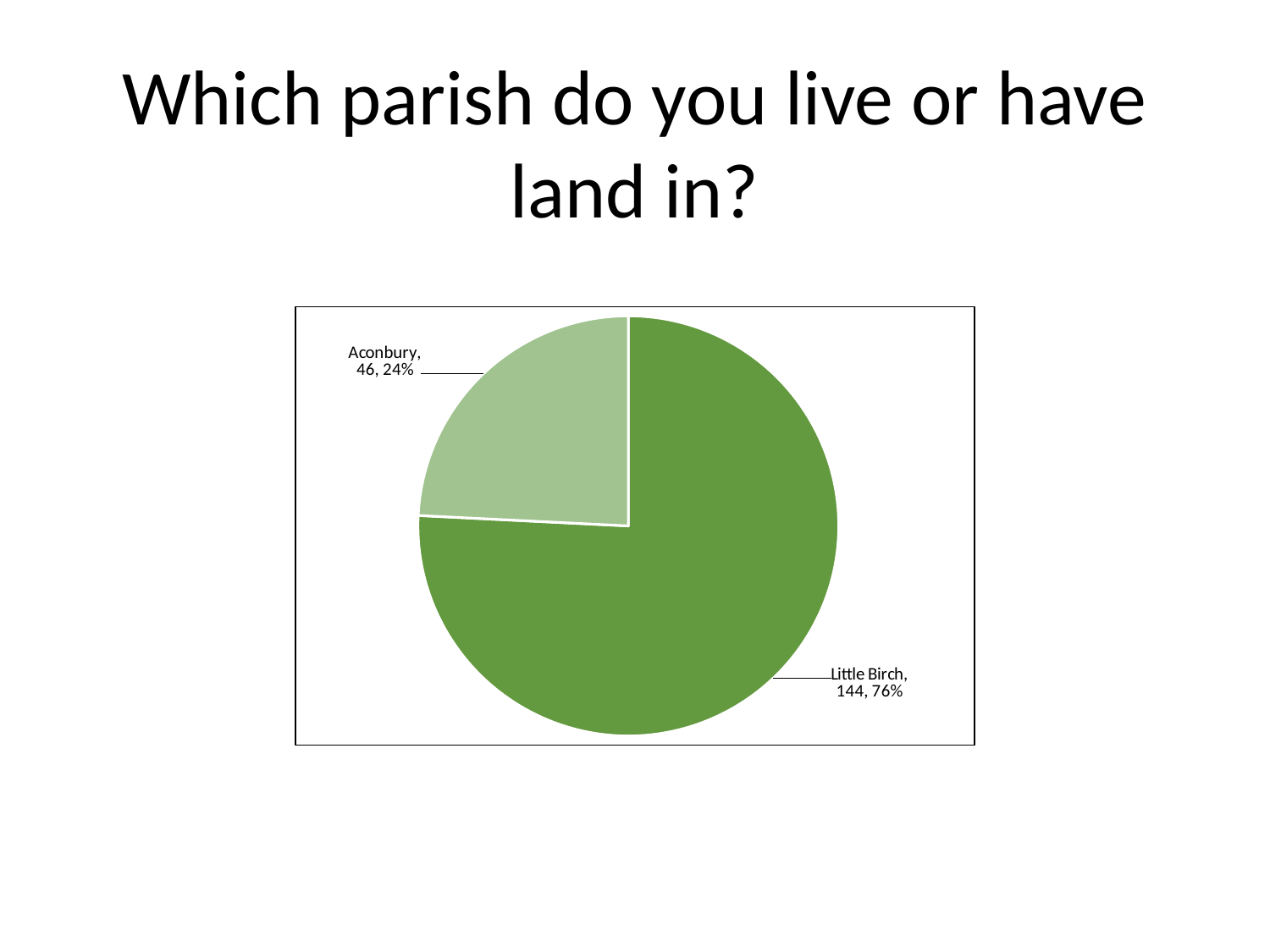
What is the value for Aconbury? 46 What share of the pie does Aconbury represent? 24% Which parish has the smallest slice? Aconbury What is the total of the two slices in the pie chart? 190 What is the difference between the values for Little Birch and Aconbury? 98 How many slices does the pie chart have? 2 What is the value for Little Birch? 144 What kind of chart is shown on the slide? pie chart What share of the pie does Little Birch represent? 76% What is the title of the slide containing the pie chart? Which parish do you live or have land in? Which is larger, the value for Little Birch or the value for Aconbury? Little Birch Which parish has the largest slice? Little Birch